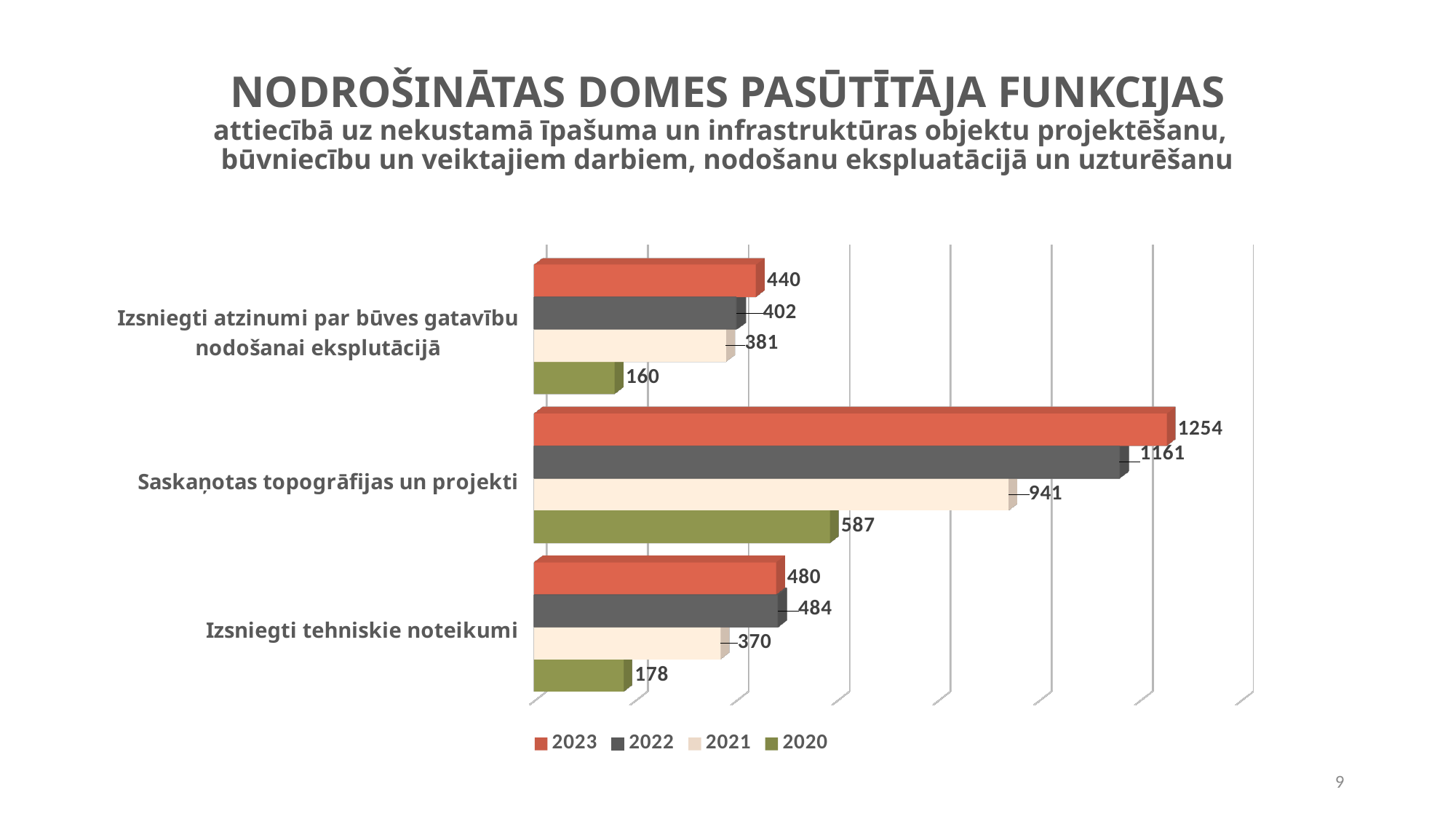
What is the difference between the 2023 and 2022 values for Saskaņotas topogrāfijas un projekti? 93 What is the 2020 value for Izsniegti tehniskie noteikumi? 178 What is the difference between the 2023 and 2020 values for Izsniegti atzinumi par būves gatavību nodošanai eksplutācijā? 280 How many categories are shown on the chart? 3 For Izsniegti tehniskie noteikumi, which year has the larger value, 2022 or 2021? 2022 Which category has the highest 2022 value? Saskaņotas topogrāfijas un projekti What kind of chart is shown on the slide? Bar chart How many series does the legend list? 4 Which year has the lowest value for Saskaņotas topogrāfijas un projekti? 2020 What is the 2021 value for Izsniegti atzinumi par būves gatavību nodošanai eksplutācijā? 381 Which colour represents the 2020 series in the legend? Green What is the 2023 value for Saskaņotas topogrāfijas un projekti? 1254